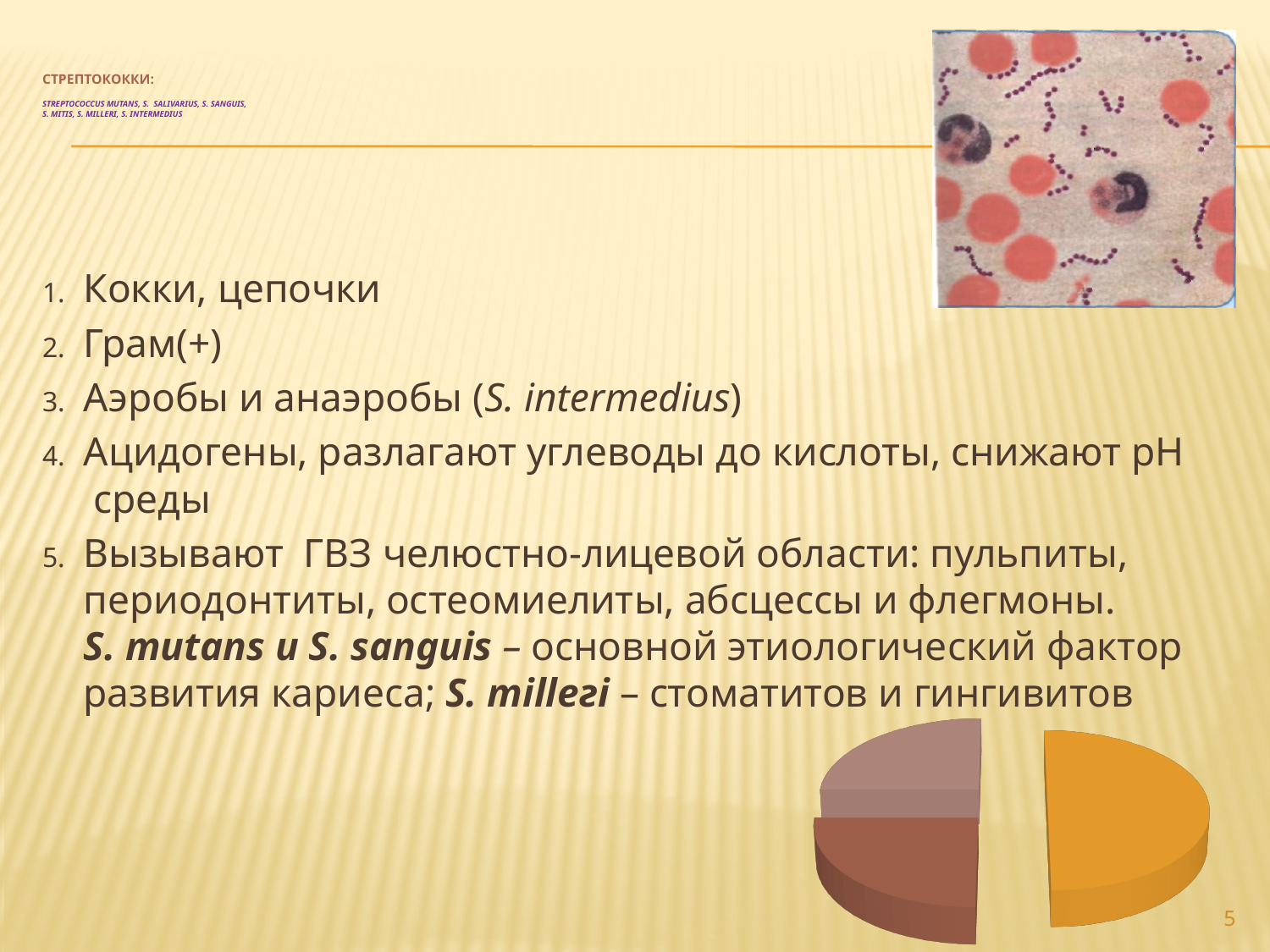
How many slices does the pie chart at the bottom of the slide have? 3 Is the pie chart at the bottom of the slide drawn in 3D or flat 2D? 3D What kind of chart is shown at the bottom of the slide? pie chart Which colour slice of the pie chart at the bottom of the slide is the largest? orange Does the pie chart at the bottom of the slide show a legend or data labels? No